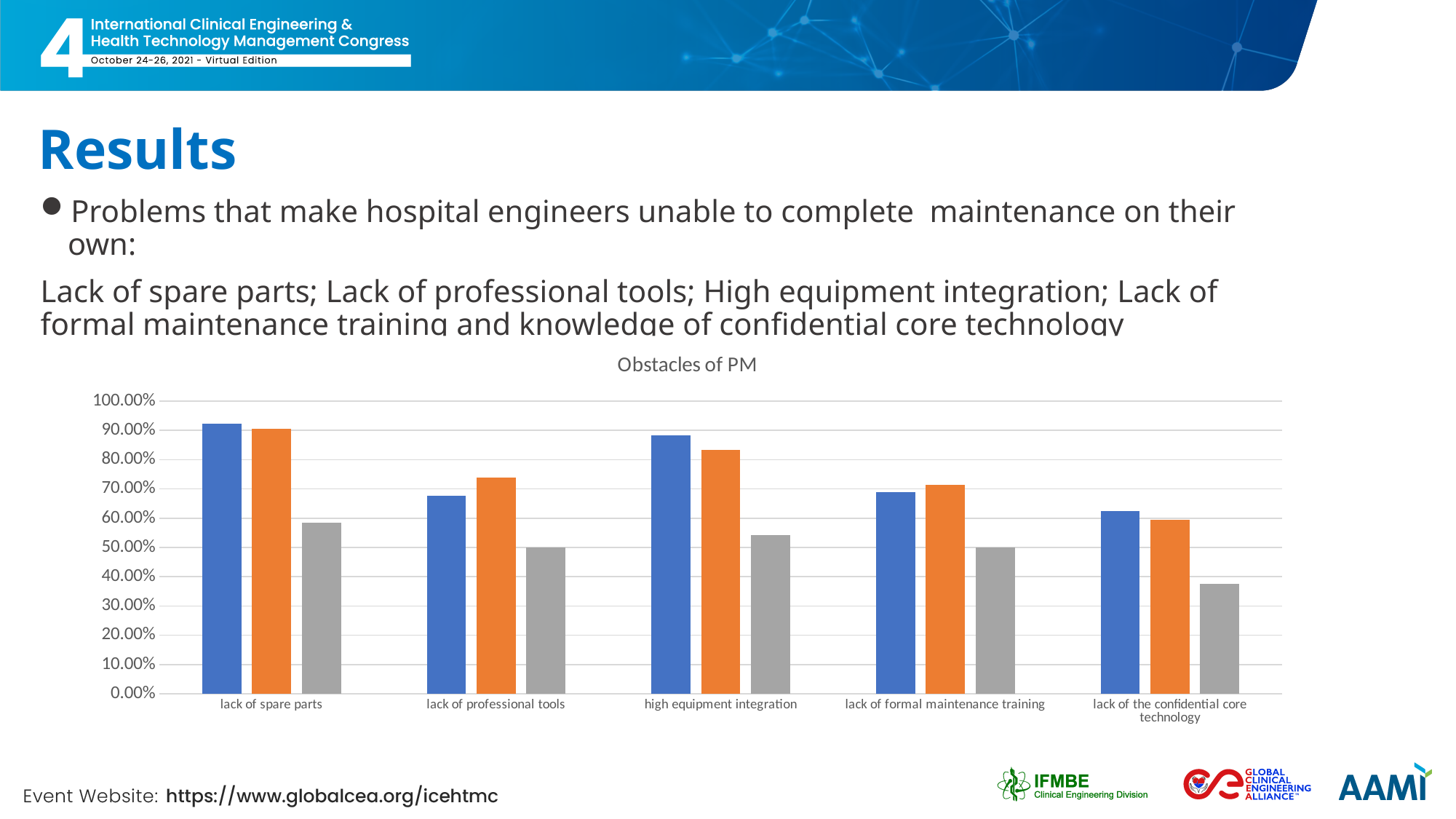
Is the orange bar for 'lack of professional tools' greater or less than 70.00%? greater Which category has the tallest blue bar? lack of spare parts How many bars are plotted for each category in the chart? 3 What is the title of the chart? Obstacles of PM What is the highest value shown on the y axis of the chart? 100.00% For 'lack of professional tools', is the blue bar or the orange bar taller? orange What kind of chart is shown on the slide? bar chart Which category has the shortest grey bar? lack of the confidential core technology How many categories are shown on the x axis of the chart? 5 Is the blue bar for 'high equipment integration' greater or less than 80.00%? greater Is the grey bar for 'lack of the confidential core technology' greater or less than 40.00%? less For 'high equipment integration', is the blue bar or the orange bar taller? blue